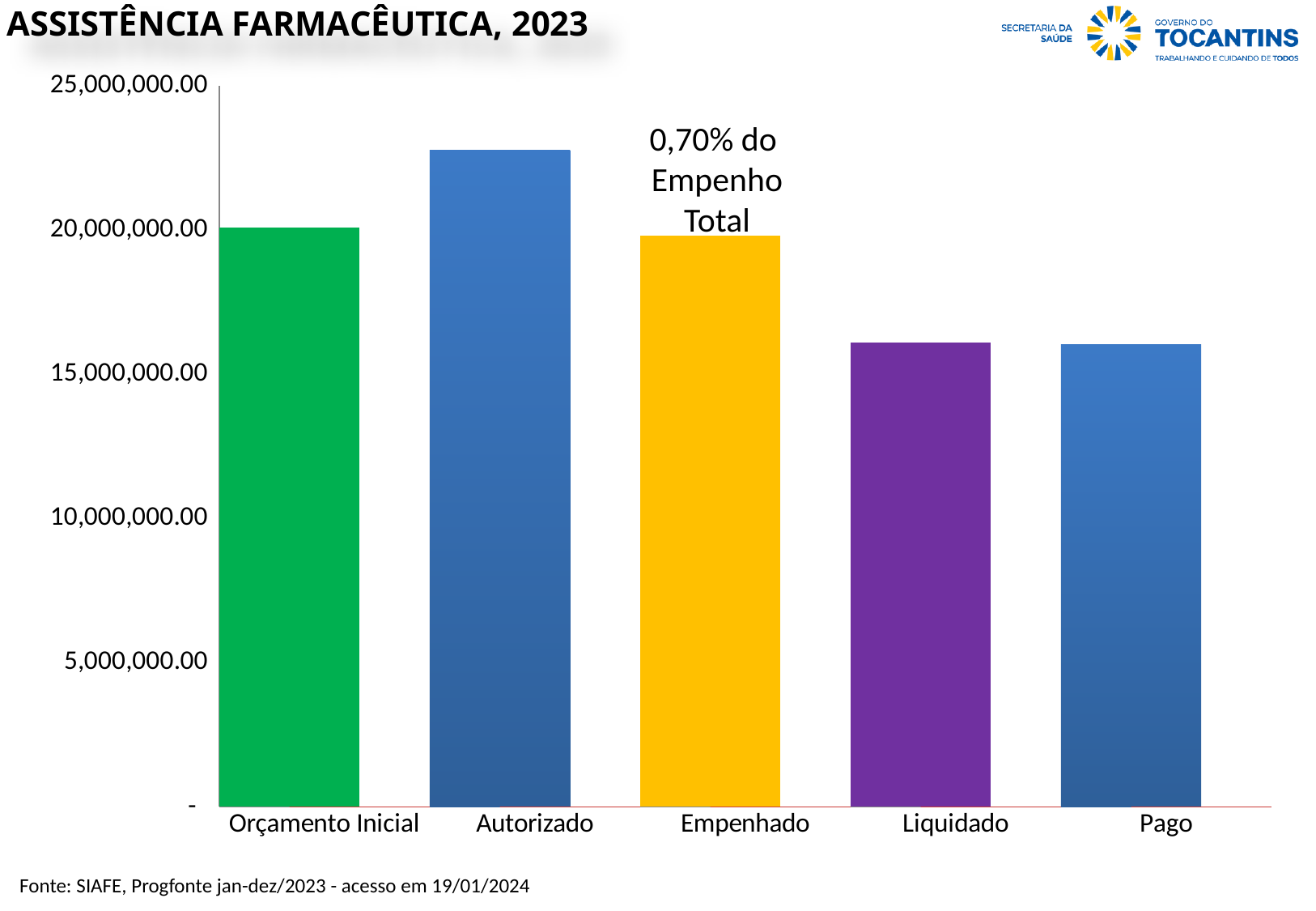
Is the value for Pago greater or less than 20,000,000.00? less Which is larger, the value for Orçamento Inicial or the value for Liquidado? Orçamento Inicial Is the value for Liquidado greater or less than 15,000,000.00? greater What kind of chart is shown on the slide? bar chart What is the title of the chart? ASSISTÊNCIA FARMACÊUTICA, 2023 What text is written above the Empenhado bar? 0,70% do Empenho Total Is the value for Autorizado greater or less than 20,000,000.00? greater Which category has the highest value? Autorizado Which is larger, the value for Autorizado or the value for Empenhado? Autorizado How many categories are plotted on the x axis? 5